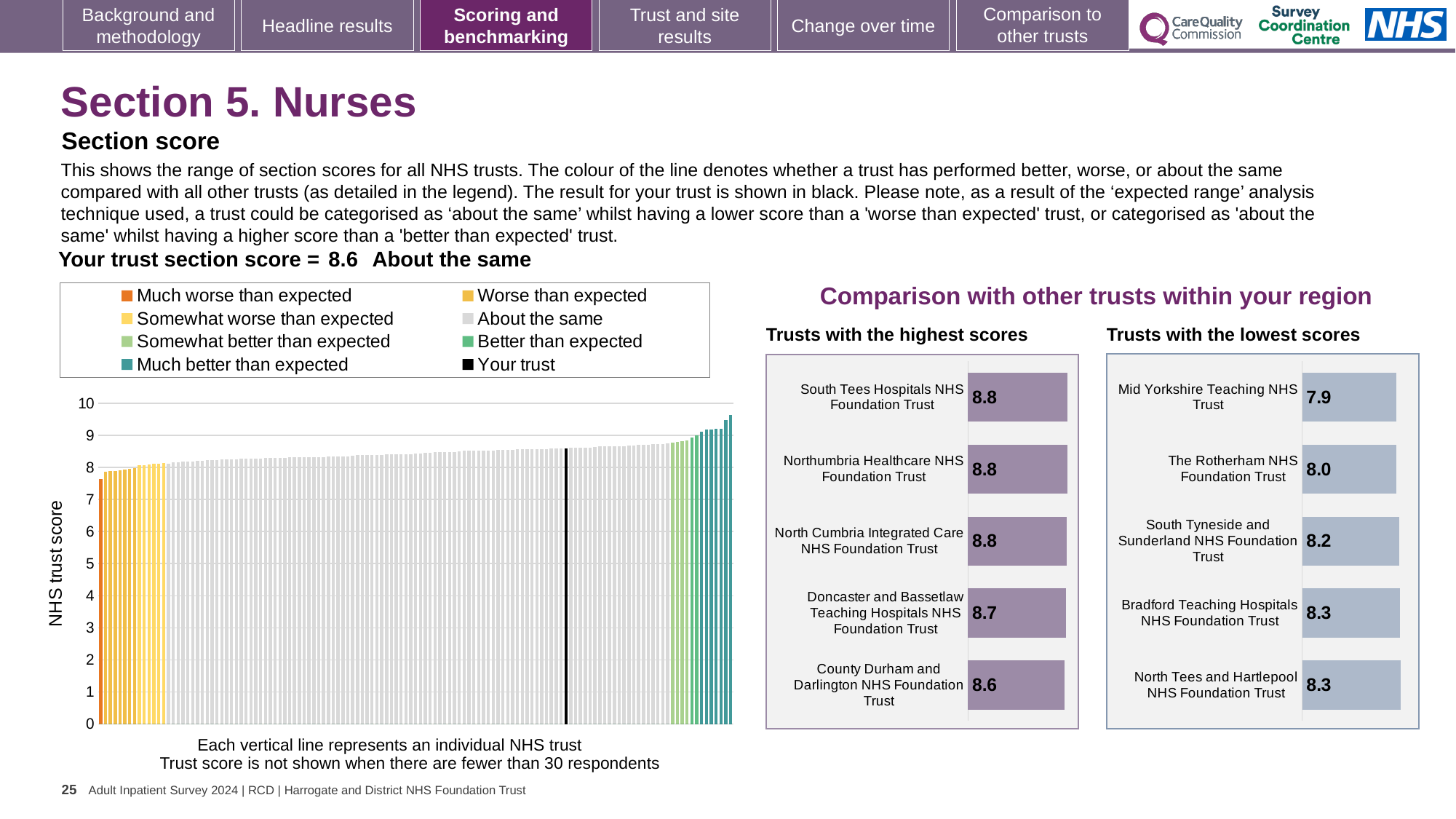
How many entries does the legend of the large chart on the left list? 8 In the 'Trusts with the lowest scores' chart, what is the difference between the score for North Tees and Hartlepool NHS Foundation Trust and the score for Mid Yorkshire Teaching NHS Trust? 0.4 In the 'Trusts with the lowest scores' chart, which trust has the lowest score? Mid Yorkshire Teaching NHS Trust In the 'Trusts with the lowest scores' chart, what is the score for Mid Yorkshire Teaching NHS Trust? 7.9 In the 'Trusts with the highest scores' chart, what is the score for County Durham and Darlington NHS Foundation Trust? 8.6 In the 'Trusts with the lowest scores' chart, which is larger: the score for The Rotherham NHS Foundation Trust or the score for South Tyneside and Sunderland NHS Foundation Trust? South Tyneside and Sunderland NHS Foundation Trust What kind of chart is the large chart on the left showing NHS trust scores? Bar chart In the 'Trusts with the highest scores' chart, what is the difference between the score for South Tees Hospitals NHS Foundation Trust and the score for County Durham and Darlington NHS Foundation Trust? 0.2 In the 'Trusts with the highest scores' chart, how many trusts are listed? 5 In the large chart on the left, do the trust scores rise or fall from left to right along the x axis? Rise In the 'Trusts with the highest scores' chart, what is the score for Doncaster and Bassetlaw Teaching Hospitals NHS Foundation Trust? 8.7 In the 'Trusts with the highest scores' chart, which trust has the lowest score? County Durham and Darlington NHS Foundation Trust